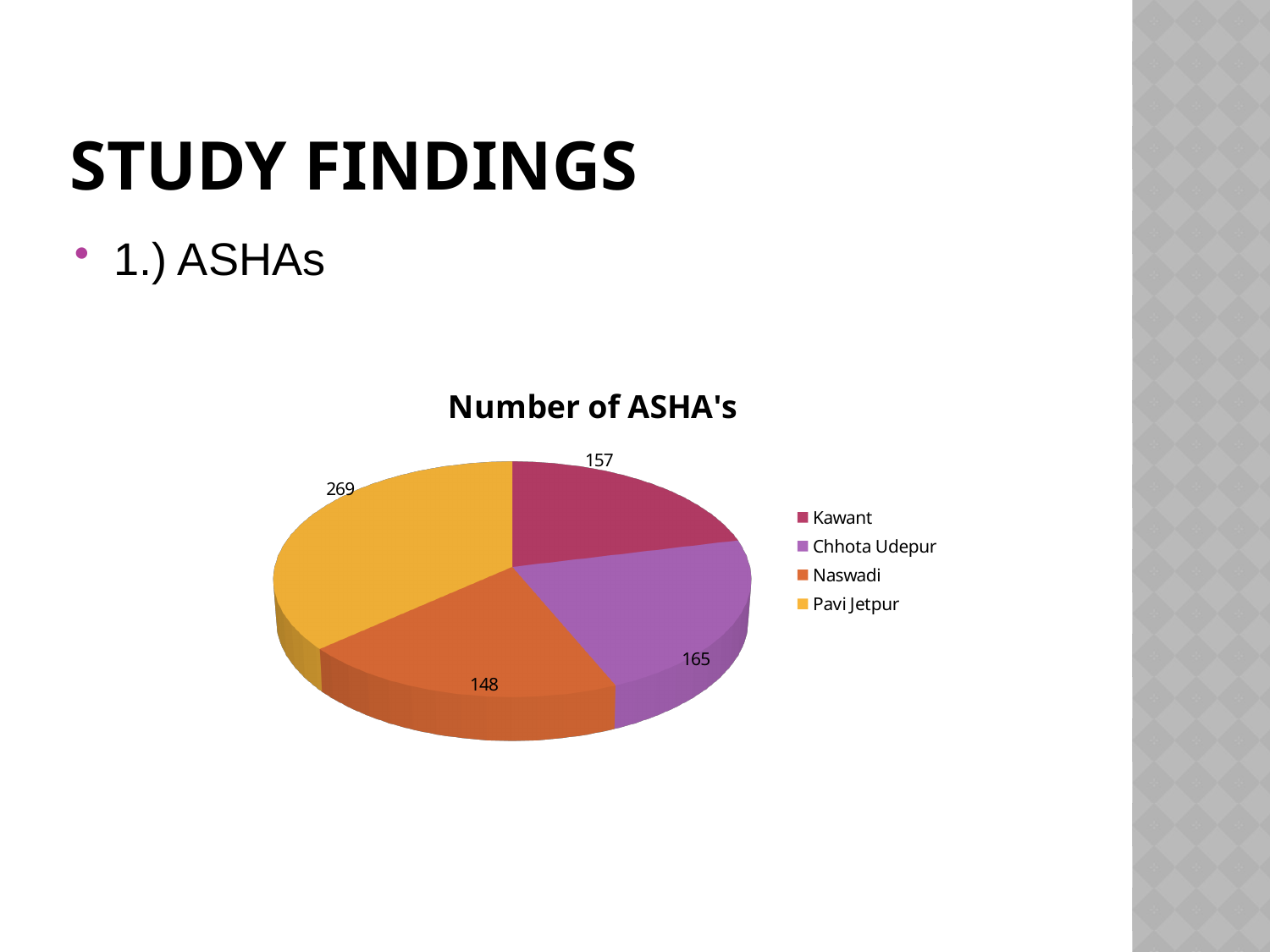
What is the number of ASHA's for Kawant? 157 Which block has the lowest number of ASHA's? Naswadi Which block has the highest number of ASHA's? Pavi Jetpur How many blocks are shown in the pie chart? 4 What is the total number of ASHA's across all four blocks? 739 What is the title of the chart? Number of ASHA's Which has more ASHA's, Kawant or Chhota Udepur? Chhota Udepur What is the difference between the number of ASHA's in Pavi Jetpur and Naswadi? 121 What is the number of ASHA's for Chhota Udepur? 165 What is the number of ASHA's for Pavi Jetpur? 269 What type of chart is shown on the slide? Pie chart What is the number of ASHA's for Naswadi? 148